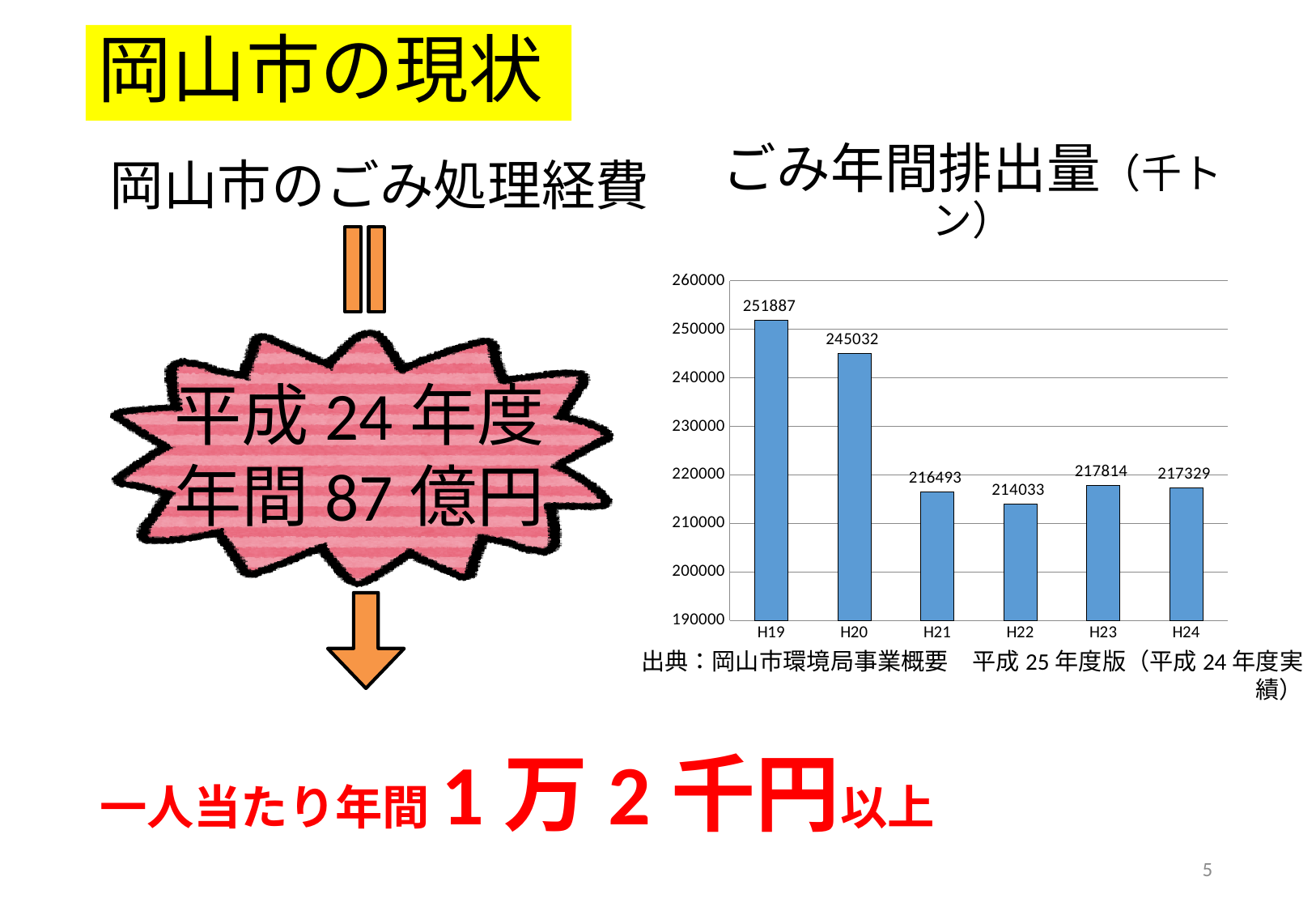
How many years are shown on the x axis of the ごみ年間排出量 chart? 6 Which is larger in the ごみ年間排出量 chart, the value for H20 or the value for H21? H20 What is the value for H24 in the ごみ年間排出量 chart? 217329 Which year has the highest value in the ごみ年間排出量 chart? H19 What is the value for H19 in the ごみ年間排出量 chart? 251887 What kind of chart is the ごみ年間排出量 chart? bar chart Do the values in the ごみ年間排出量 chart generally rise or fall from H19 to H24? fall What is the value for H22 in the ごみ年間排出量 chart? 214033 What is the difference between the H23 and H22 values in the ごみ年間排出量 chart? 3781 Which year has the lowest value in the ごみ年間排出量 chart? H22 What is the difference between the H19 and H20 values in the ごみ年間排出量 chart? 6855 Is the value for H21 in the ごみ年間排出量 chart greater or less than 220000? less